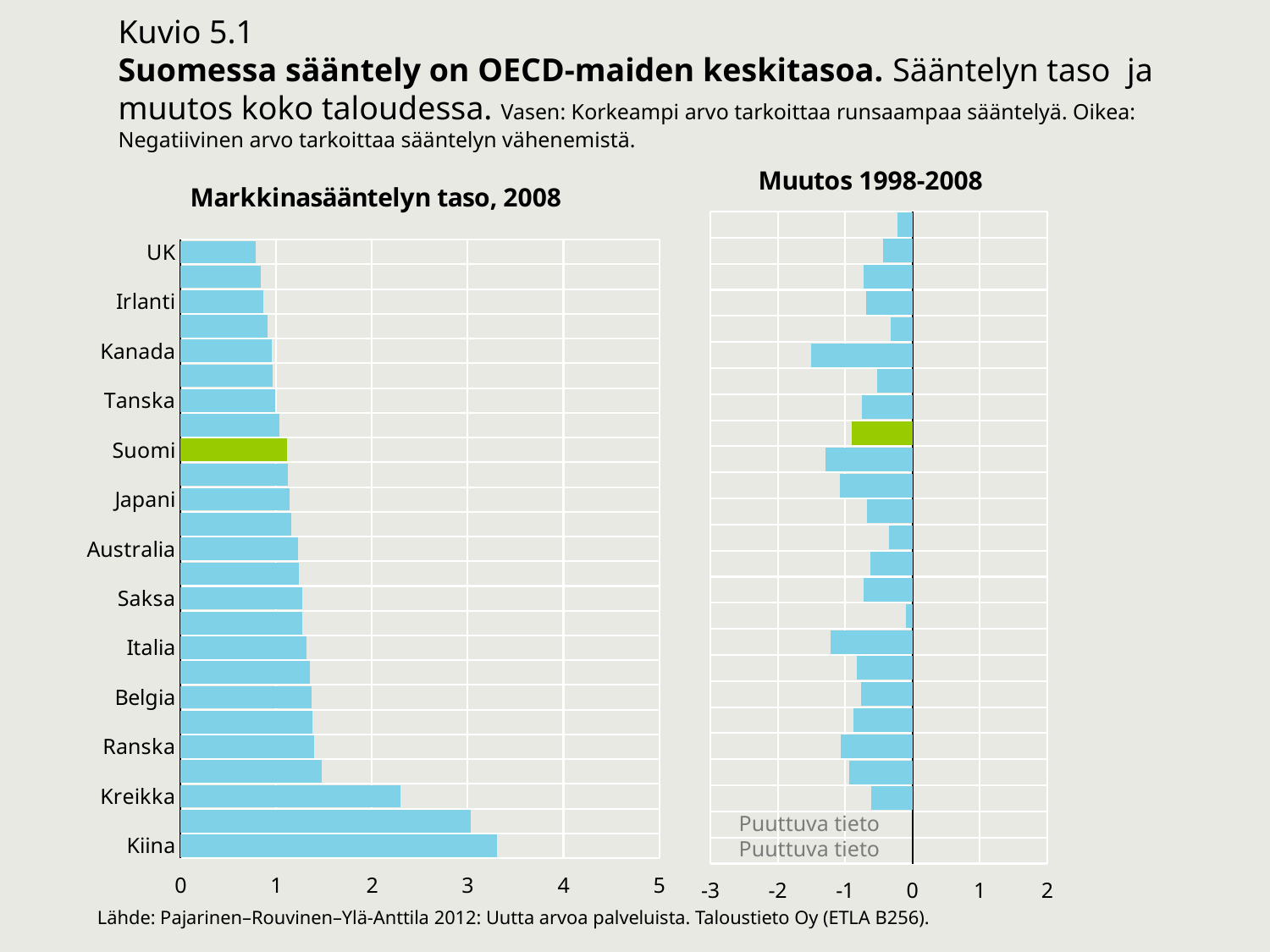
In the chart 'Markkinasääntelyn taso, 2008', is the value for Ranska greater or less than 1? greater In the chart 'Markkinasääntelyn taso, 2008', is the value for Kiina greater or less than 3? greater What kind of chart is 'Markkinasääntelyn taso, 2008'? bar chart In the chart 'Markkinasääntelyn taso, 2008', is the value for Kreikka greater or less than 2? greater In the chart 'Markkinasääntelyn taso, 2008', which country's bar is highlighted in green? Suomi In the chart 'Markkinasääntelyn taso, 2008', which is larger, the value for UK or the value for Kreikka? Kreikka In the chart 'Markkinasääntelyn taso, 2008', which is larger, the value for Kreikka or the value for Kiina? Kiina In the chart 'Markkinasääntelyn taso, 2008', which country has the lowest value? UK In the chart 'Markkinasääntelyn taso, 2008', which country has the highest value? Kiina